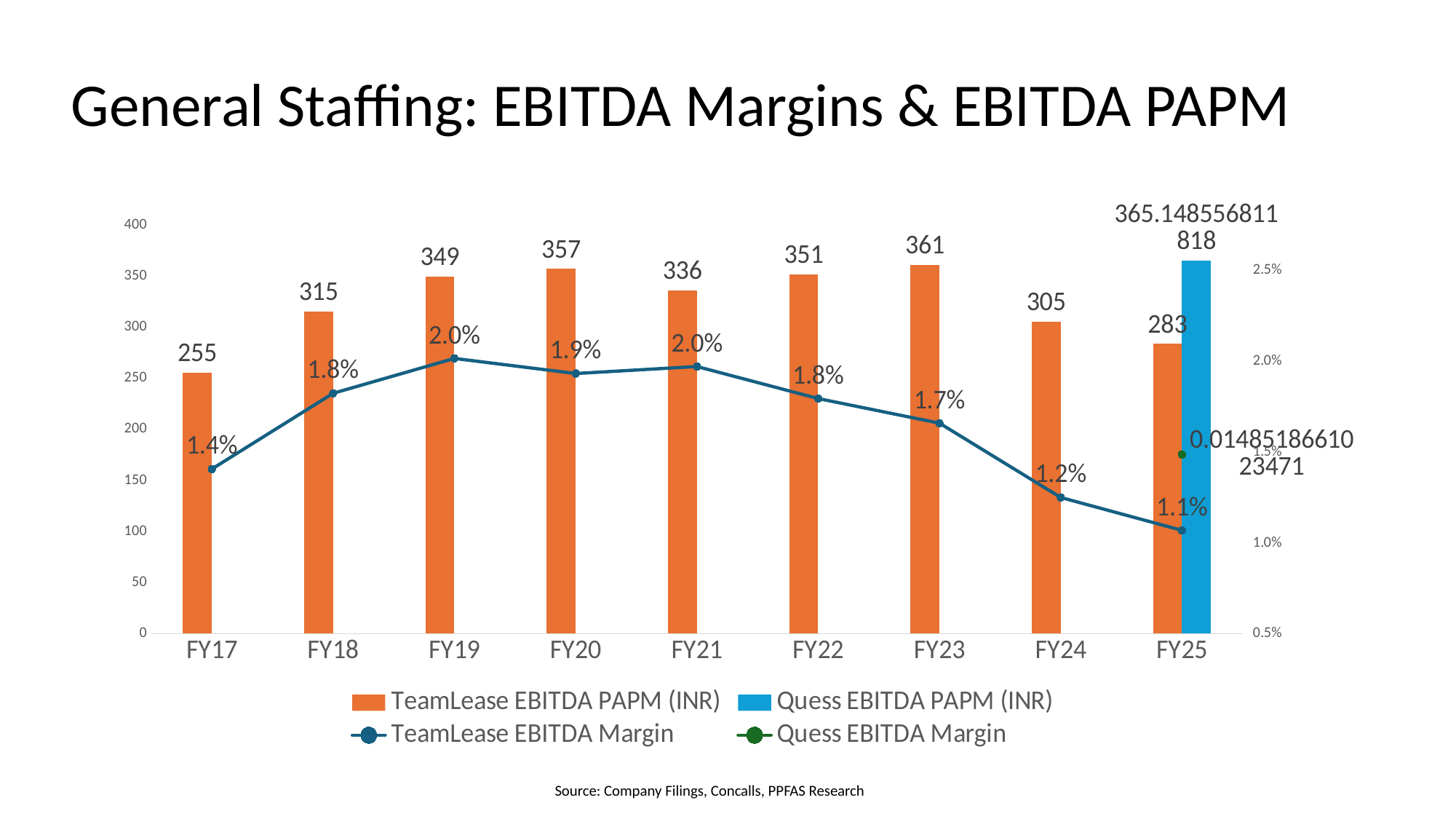
How many series does the legend list? 4 Does the TeamLease EBITDA Margin rise or fall from FY21 to FY25? Fall What is the TeamLease EBITDA PAPM (INR) for FY20? 357 What is the TeamLease EBITDA Margin for FY19? 2.0% Which fiscal year has the highest TeamLease EBITDA PAPM (INR)? FY23 Which fiscal year has the lowest TeamLease EBITDA PAPM (INR)? FY17 How many fiscal years are shown on the x axis? 9 What is the TeamLease EBITDA PAPM (INR) for FY25? 283 What is the difference between the TeamLease EBITDA PAPM (INR) for FY23 and FY24? 56 Which fiscal year has the lowest TeamLease EBITDA Margin? FY25 What kind of chart is this? Combined bar and line chart Which is larger, the TeamLease EBITDA PAPM (INR) for FY18 or for FY21? FY21